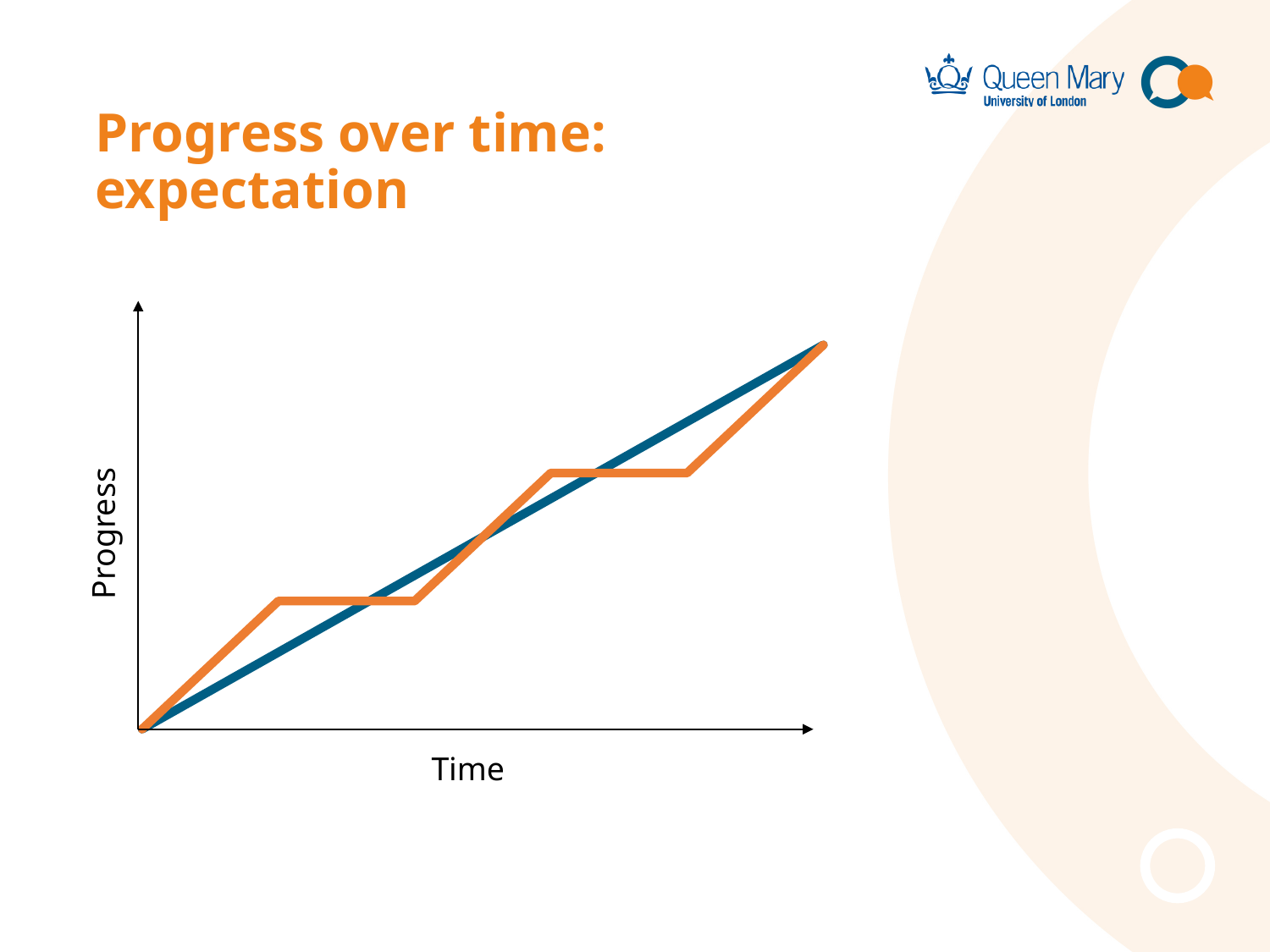
Does the blue line rise or fall as time increases along the x axis? Rise How many flat (plateau) segments does the orange line have? 2 Do the blue and orange lines end at the same point on the chart? Yes What is the label on the horizontal axis of the chart? Time Overall, does the orange line rise or fall from the left to the right of the chart? Rise Do the blue and orange lines start at the same point on the chart? Yes What kind of chart is shown on the slide? Line chart How many lines are plotted on the chart? 2 Which line is straight, the blue one or the orange one? The blue one What is the label on the vertical axis of the chart? Progress